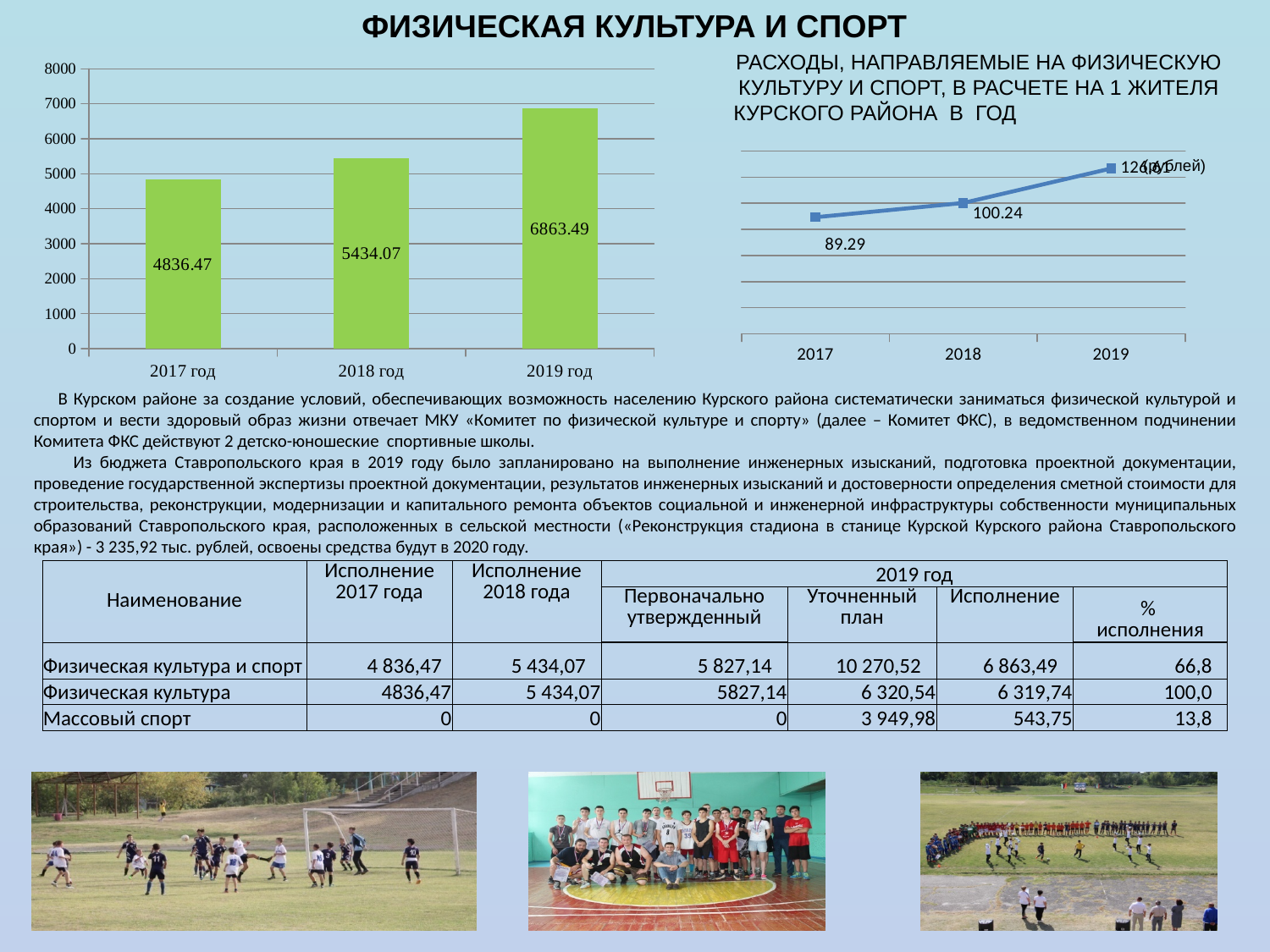
In the left bar chart, what is the value for 2017 год? 4836.47 In the left bar chart, which year has the highest value? 2019 год In the left bar chart, is the value for 2019 год greater or less than 6000? greater In the left bar chart, how many years are shown? 3 In the right line chart (расходы на физическую культуру и спорт в расчете на 1 жителя), what is the value for 2018? 100.24 In the right line chart (расходы на физическую культуру и спорт в расчете на 1 жителя), what is the value for 2017? 89.29 What kind of chart is the chart on the left of the slide? bar chart In the left bar chart, what is the value for 2019 год? 6863.49 In the left bar chart, what is the difference between the values for 2019 год and 2017 год? 2027.02 In the right line chart (расходы на физическую культуру и спорт в расчете на 1 жителя), which year has the lowest value? 2017 In the left bar chart, do the values rise or fall from 2017 год to 2019 год? rise In the left bar chart, which year has the lowest value? 2017 год